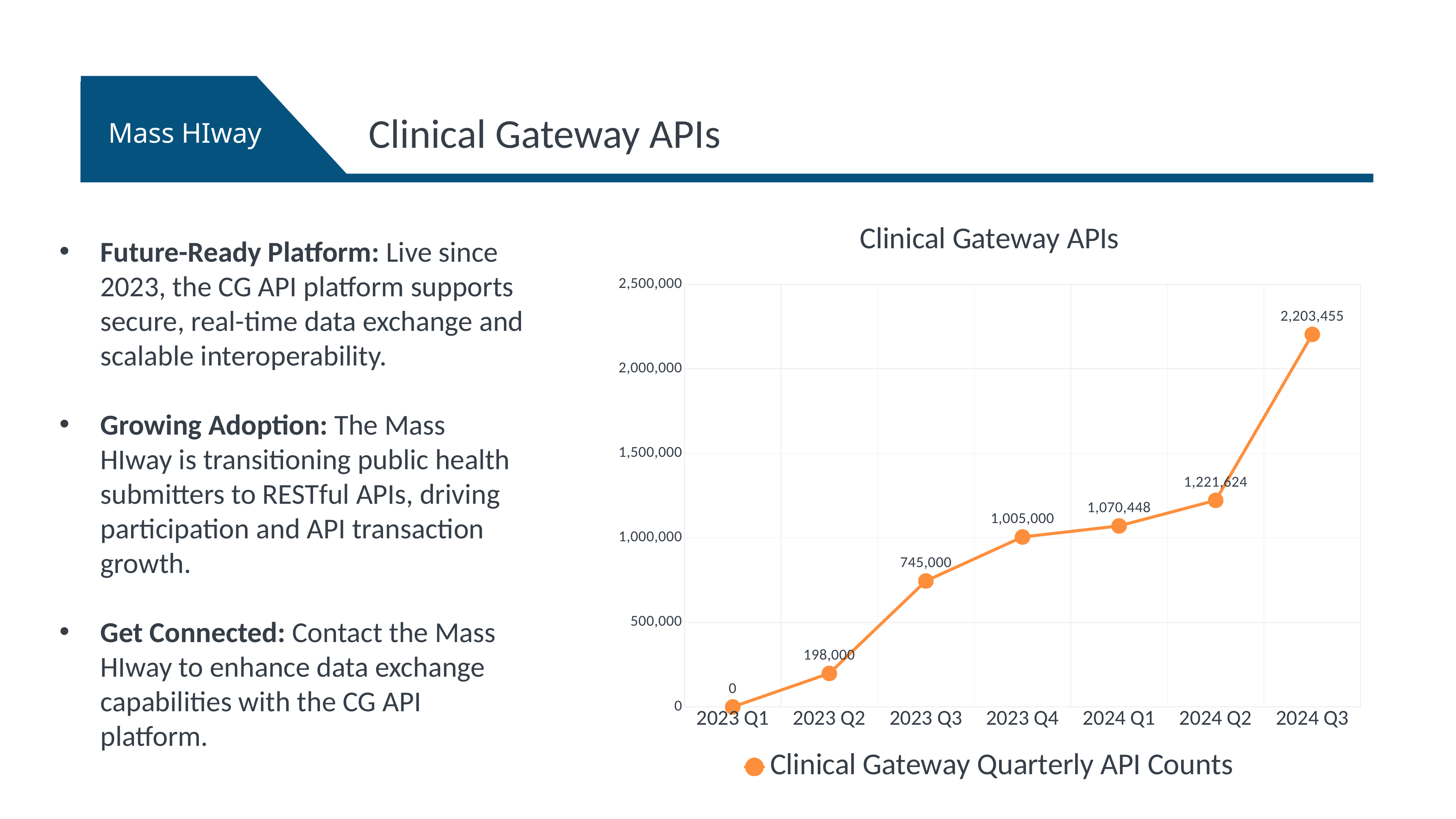
What is the value for 2024 Q1? 1,070,448 What is the legend entry for the plotted series? Clinical Gateway Quarterly API Counts What is the difference between the values for 2023 Q3 and 2023 Q2? 547,000 What is the value for 2024 Q3? 2,203,455 Which quarter has the highest value? 2024 Q3 What is the difference between the values for 2024 Q3 and 2024 Q2? 981,831 Do the values rise or fall from 2023 Q1 to 2024 Q3? Rise Which quarter has the lowest value? 2023 Q1 What is the value for 2023 Q3? 745,000 What type of chart is shown on the slide? Line chart How many quarters are plotted on the chart? 7 Which is larger, the value for 2023 Q4 or the value for 2024 Q2? 2024 Q2